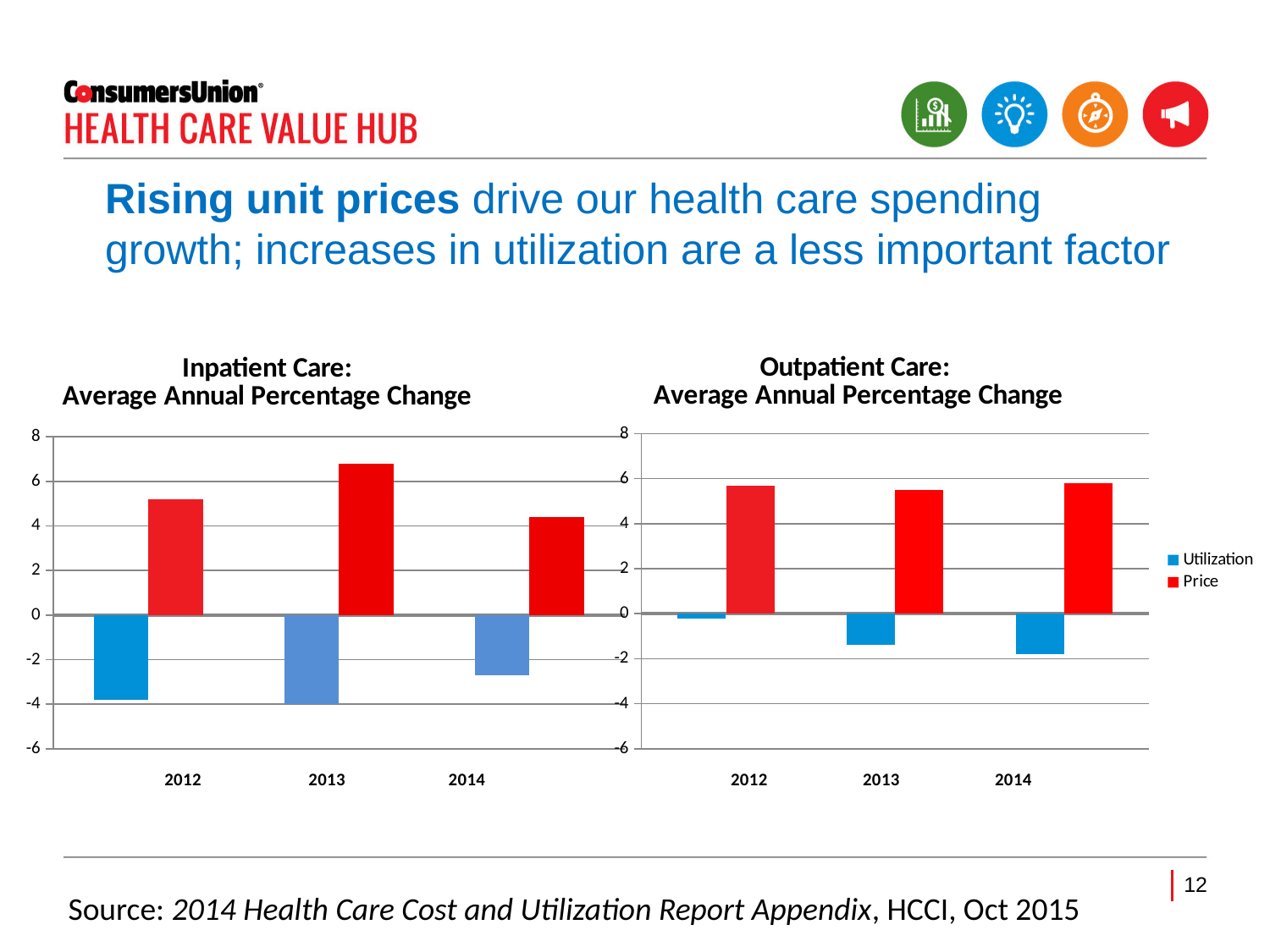
In the Inpatient Care chart, is the Price value for 2013 greater or less than 6? greater In the Inpatient Care chart, which year has the lowest Price value? 2014 In the Inpatient Care chart, which year has the highest Price value? 2013 How many years are shown on the x axis of the Outpatient Care chart? 3 In the Inpatient Care chart, which year has the larger Price value, 2012 or 2014? 2012 In the Outpatient Care chart, is the Price value for 2014 greater or less than 4? greater What colour represents the Price series in the legend? red How many series does the legend list? 2 In the Outpatient Care chart, is the Utilization value for 2012 greater or less than -1? greater What kind of chart is the Inpatient Care chart? bar chart In the Outpatient Care chart, which year has the lower Utilization value, 2013 or 2014? 2014